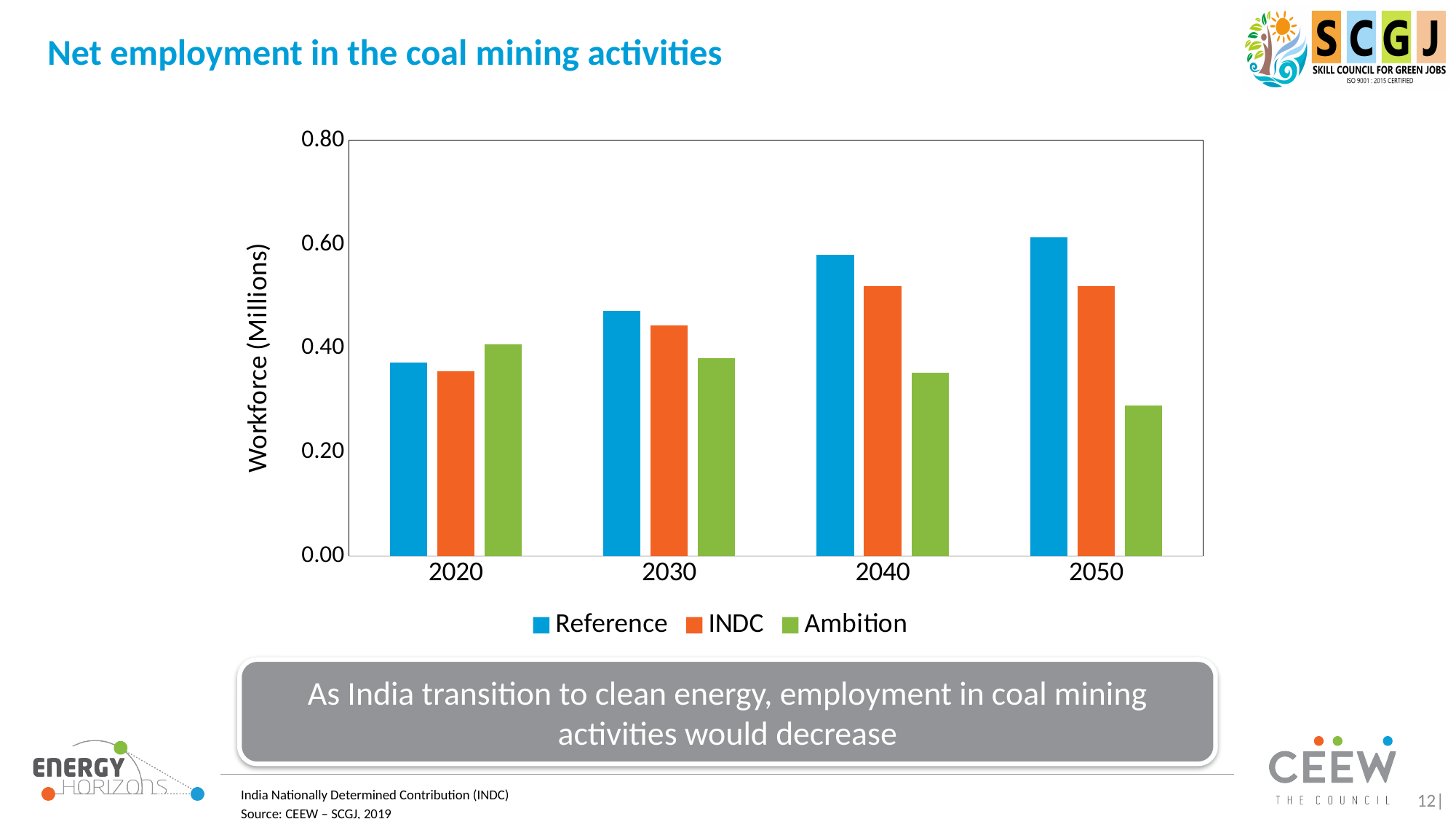
How many series does the legend list? 3 Is the value for Reference in 2050 greater or less than 0.40? greater Is the value for Ambition in 2050 greater or less than 0.40? less In which year is the Ambition series lowest? 2050 Does the Ambition series rise or fall from 2020 to 2050? fall Is the value for INDC in 2040 greater or less than 0.40? greater What kind of chart is shown on the slide? bar chart In which year is the Reference series highest? 2050 In 2050, which is larger: Reference or Ambition? Reference Which series is shown in green in the legend? Ambition How many years are shown on the x axis? 4 What is the label of the y axis? Workforce (Millions)